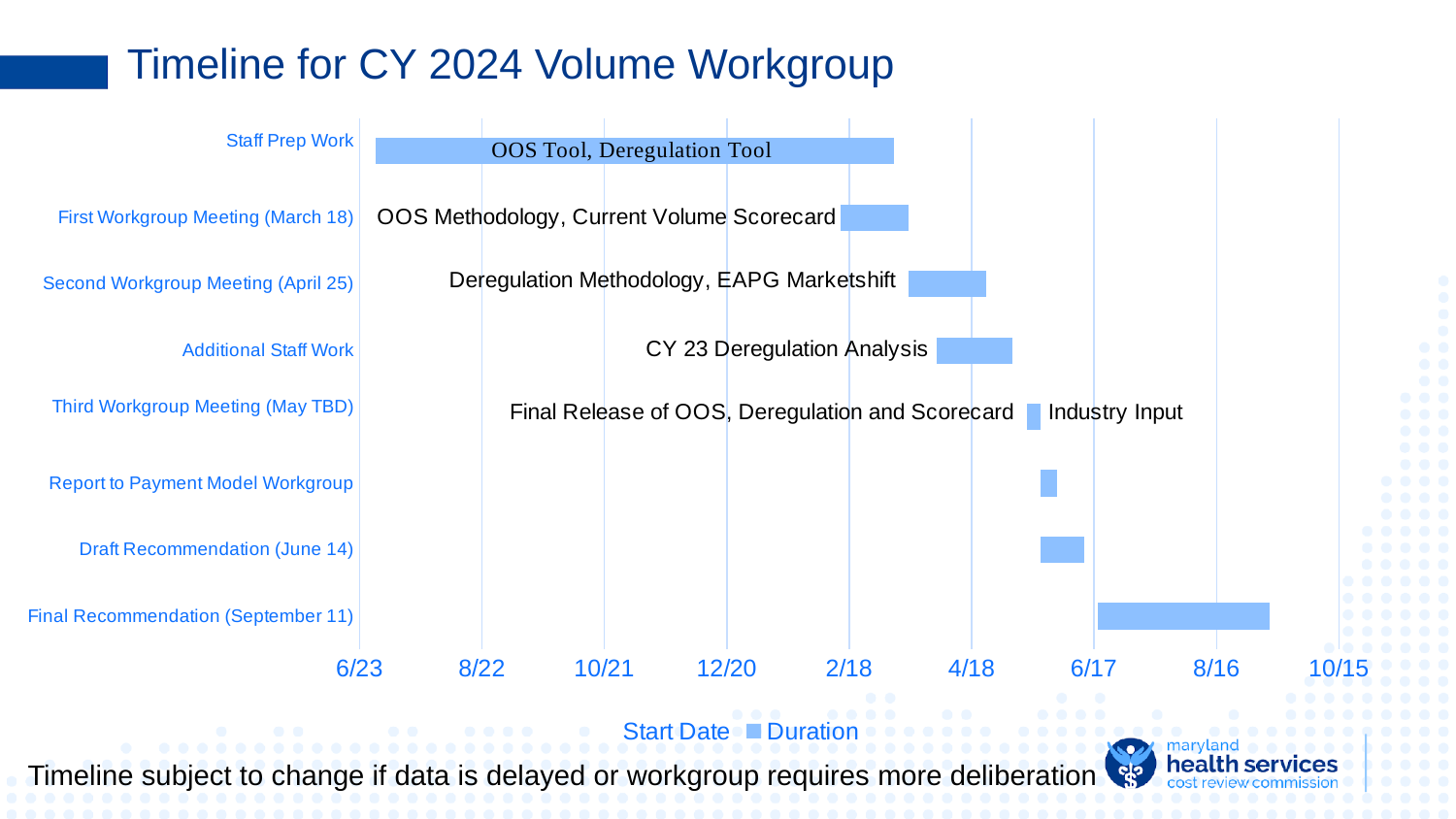
What kind of chart is shown on the slide? Bar chart Do the start dates of the bars get later or earlier moving down the list of categories? Later Which has the longer Duration bar: Additional Staff Work or Report to Payment Model Workgroup? Additional Staff Work What is the title of the chart? Timeline for CY 2024 Volume Workgroup How many series does the legend list? 2 What are the two entries in the chart legend? Start Date, Duration What text label is shown next to the Additional Staff Work bar? CY 23 Deregulation Analysis Which has the longer Duration bar: Staff Prep Work or Final Recommendation (September 11)? Staff Prep Work What text label is shown on the Staff Prep Work bar? OOS Tool, Deregulation Tool How many categories (rows) are plotted on the chart? 8 Which category has the longest Duration bar? Staff Prep Work Which category has the shortest Duration bar? Third Workgroup Meeting (May TBD)